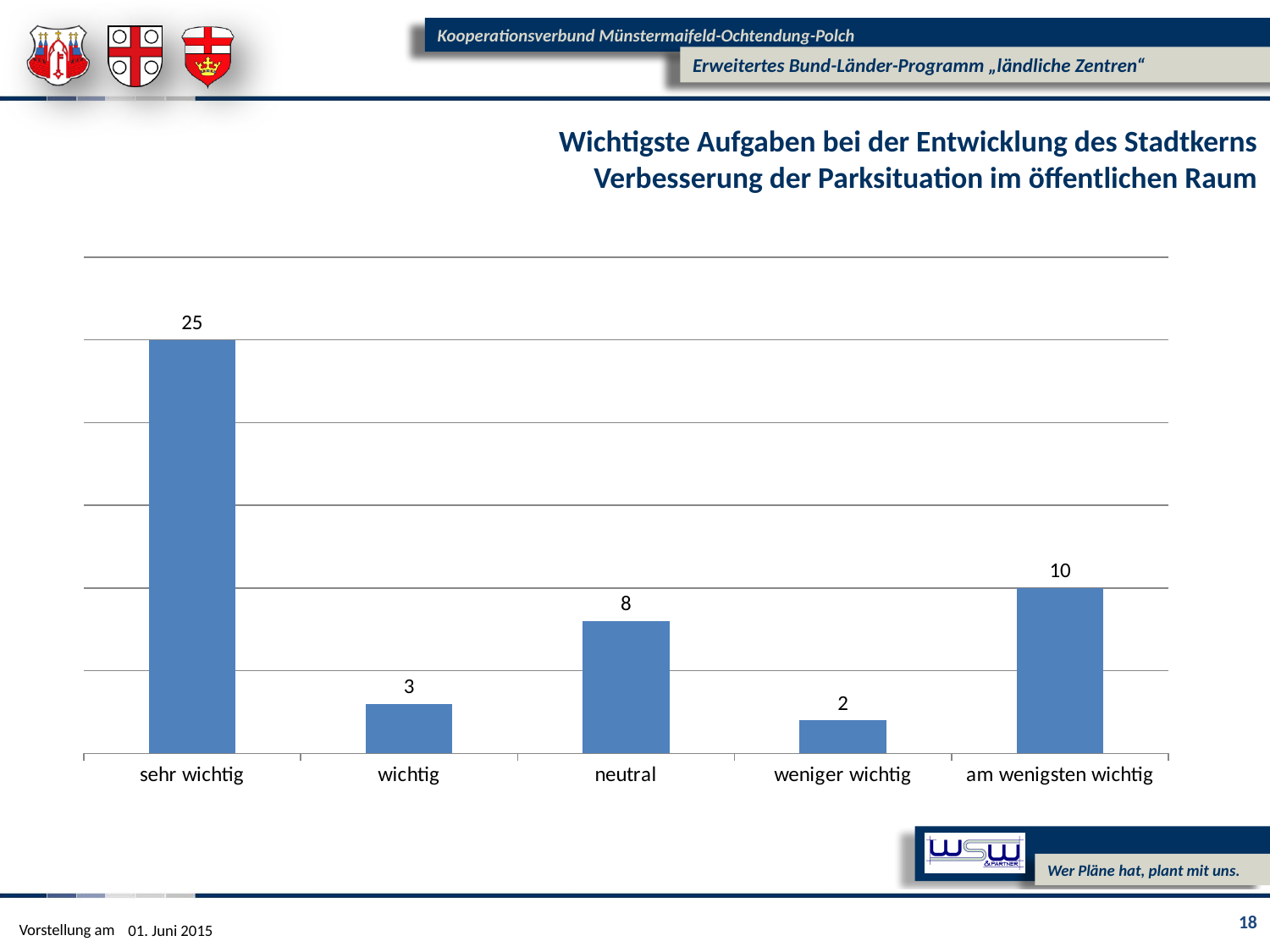
Which is larger, the value for "neutral" or the value for "am wenigsten wichtig"? am wenigsten wichtig What kind of chart is shown on the slide? bar chart What is the second line of the chart title? Verbesserung der Parksituation im öffentlichen Raum What is the value for "sehr wichtig"? 25 What is the value for "am wenigsten wichtig"? 10 Which category has the highest value? sehr wichtig What is the value for "weniger wichtig"? 2 What is the difference between the values for "neutral" and "wichtig"? 5 What is the value for "neutral"? 8 What is the difference between the values for "sehr wichtig" and "am wenigsten wichtig"? 15 How many categories are shown on the x axis? 5 Which category has the lowest value? weniger wichtig